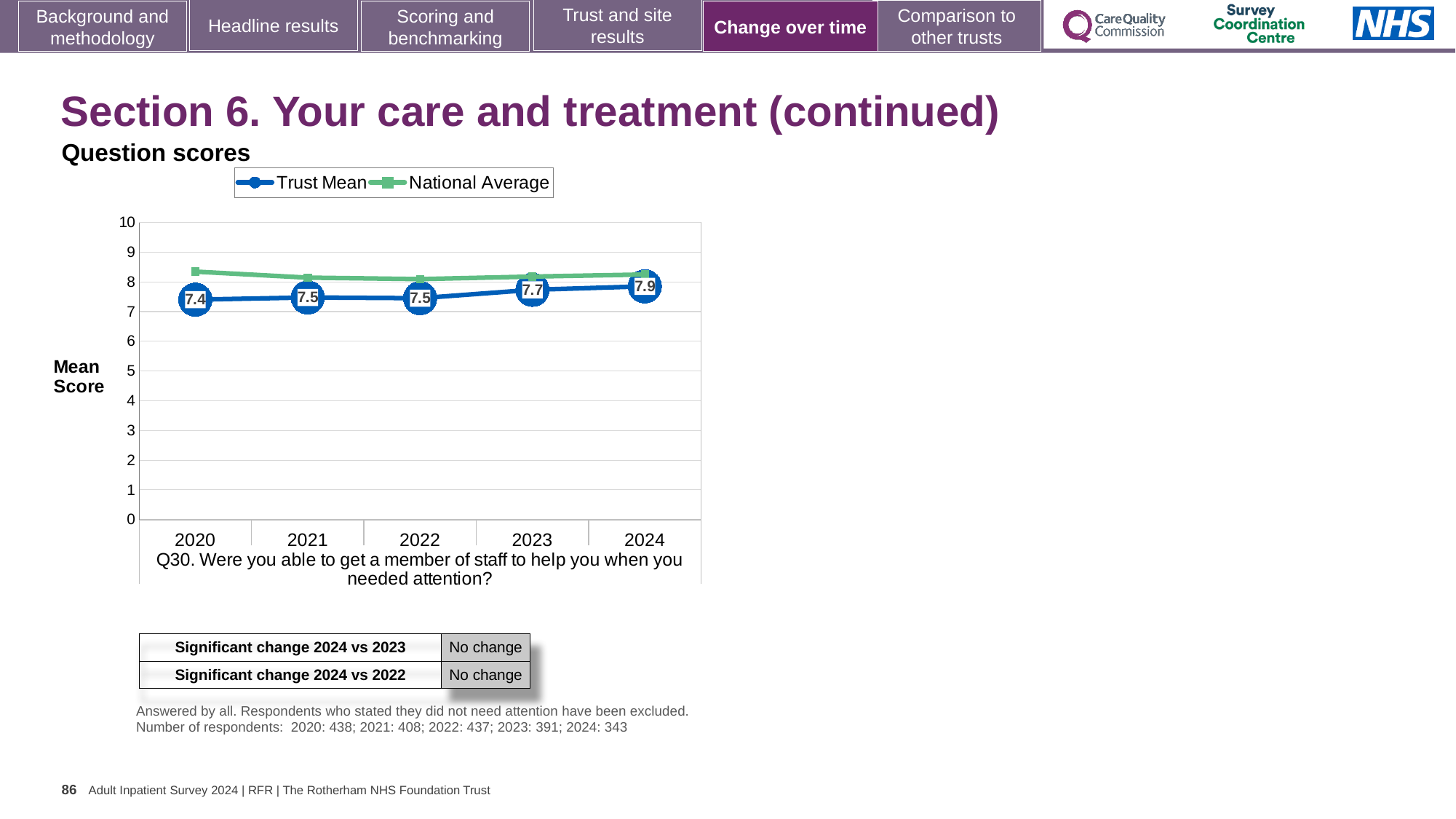
Does the Trust Mean score rise or fall from 2020 to 2024? Rise How many years are plotted on the x axis? 5 What is the Trust Mean score for 2023? 7.7 What is the Trust Mean score for 2020? 7.4 What is the Trust Mean score for 2024? 7.9 Which year has the lowest Trust Mean score? 2020 Which year has the highest Trust Mean score? 2024 What kind of chart is shown? Line chart What is the difference between the Trust Mean score in 2024 and in 2020? 0.5 Is the Trust Mean score for 2023 larger than the Trust Mean score for 2021? Yes Is the National Average value for 2020 greater or less than 8? greater How many series does the legend list? 2